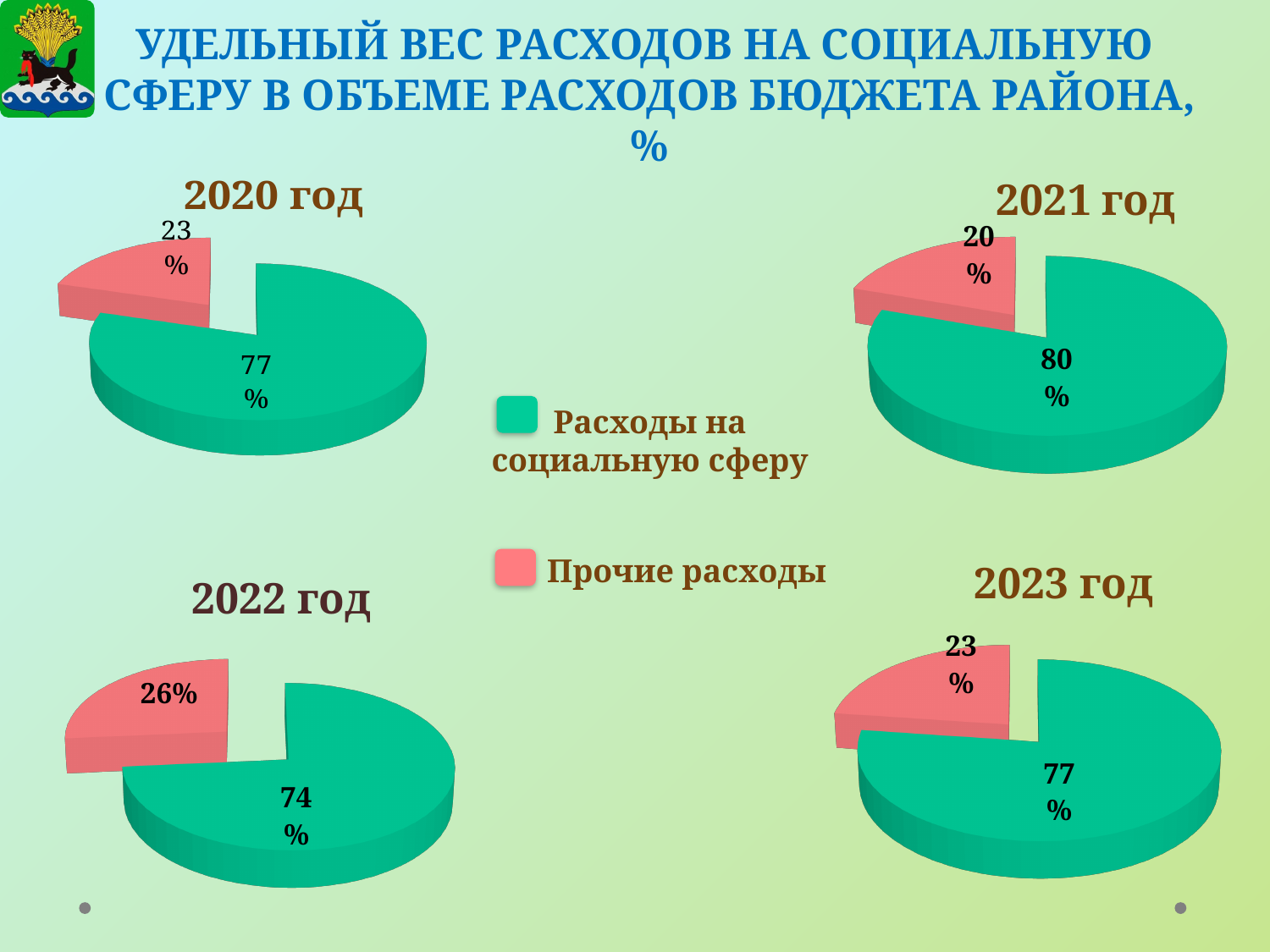
Across the four pie charts, which year shows the lowest share for Расходы на социальную сферу? 2022 год In the 2020 год pie chart, what share is shown for Расходы на социальную сферу? 77% In the 2021 год pie chart, what share is shown for Прочие расходы? 20% In the 2022 год pie chart, what share is shown for Расходы на социальную сферу? 74% In the 2022 год pie chart, what is the difference between the Расходы на социальную сферу share and the Прочие расходы share? 48% How many slices does the 2020 год pie chart have? 2 What kind of chart is used for each year on this slide? Pie chart Across the four pie charts, which year shows the highest share for Расходы на социальную сферу? 2021 год Which colour represents Прочие расходы in the legend? Pink How many entries does the legend list? 2 In the 2023 год pie chart, what share is shown for Прочие расходы? 23% In the 2021 год pie chart, which slice is larger: Расходы на социальную сферу or Прочие расходы? Расходы на социальную сферу